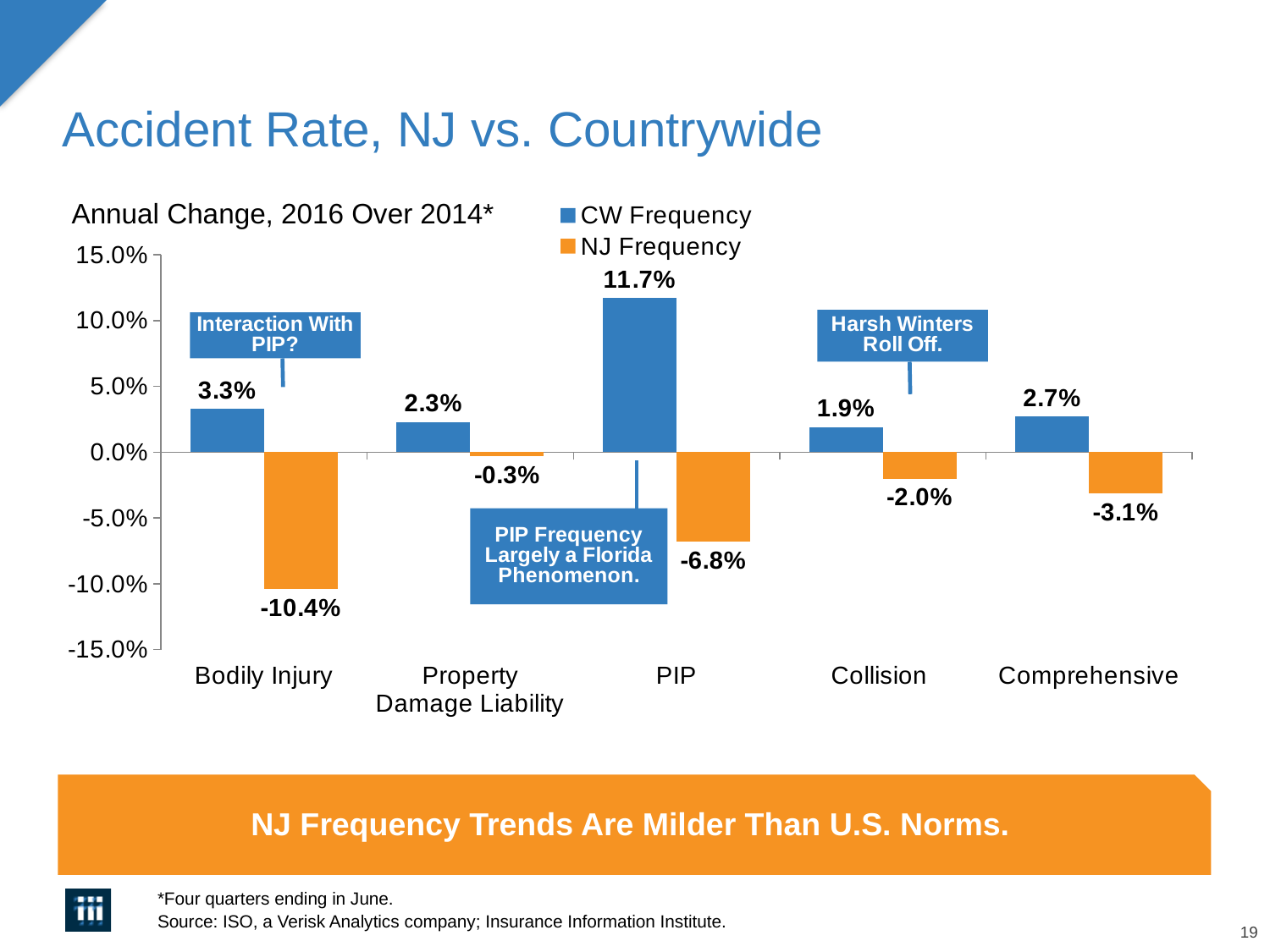
Which category has the lowest NJ Frequency value? Bodily Injury What is the difference between the CW Frequency and NJ Frequency values for PIP? 18.5 percentage points What kind of chart is shown on the slide? Bar chart What is the NJ Frequency value for Bodily Injury? -10.4% How many categories are shown on the x axis? 5 What is the CW Frequency value for PIP? 11.7% How many series does the legend list? 2 What is the CW Frequency value for Collision? 1.9% Which is larger, the CW Frequency value for Bodily Injury or the CW Frequency value for Comprehensive? Bodily Injury Which category has the highest CW Frequency value? PIP What is the NJ Frequency value for Comprehensive? -3.1% Which colour represents NJ Frequency in the chart? Orange